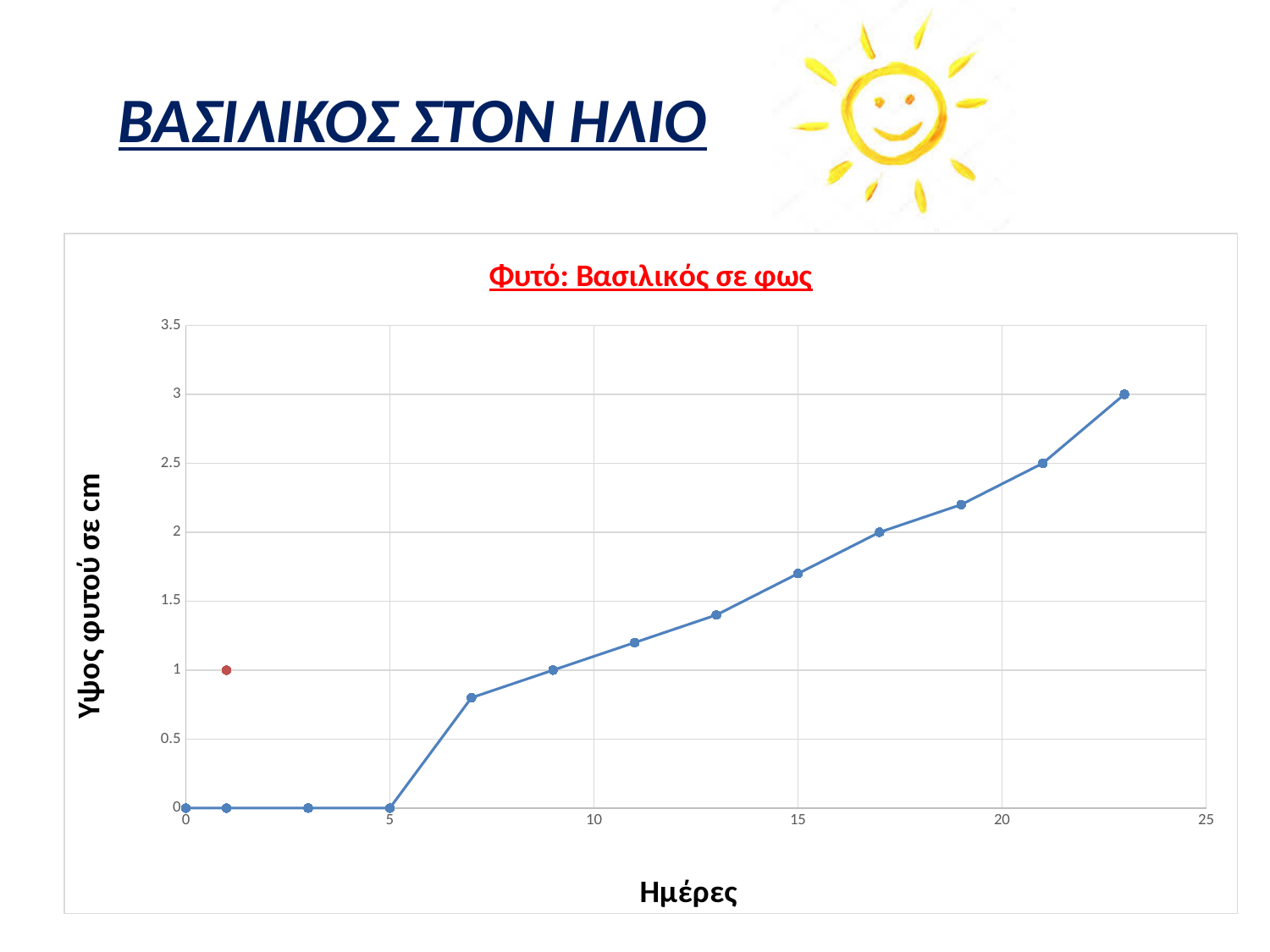
What is the plant height on day 5? 0 What is the plant height on day 21? 2.5 Is the plant height on day 7 greater or less than 1? less What is the plant height on day 9? 1 What is the title of the chart? Φυτό: Βασιλικός σε φως What is the plant height on day 23? 3 Does the plant height rise or fall as the days increase? rise What kind of chart is shown on the slide? line chart Is the plant height on day 15 greater or less than 1.5? greater What is the plant height on day 17? 2 On which day is the plant height highest? 23 What is the label of the vertical axis? Ύψος φυτού σε cm